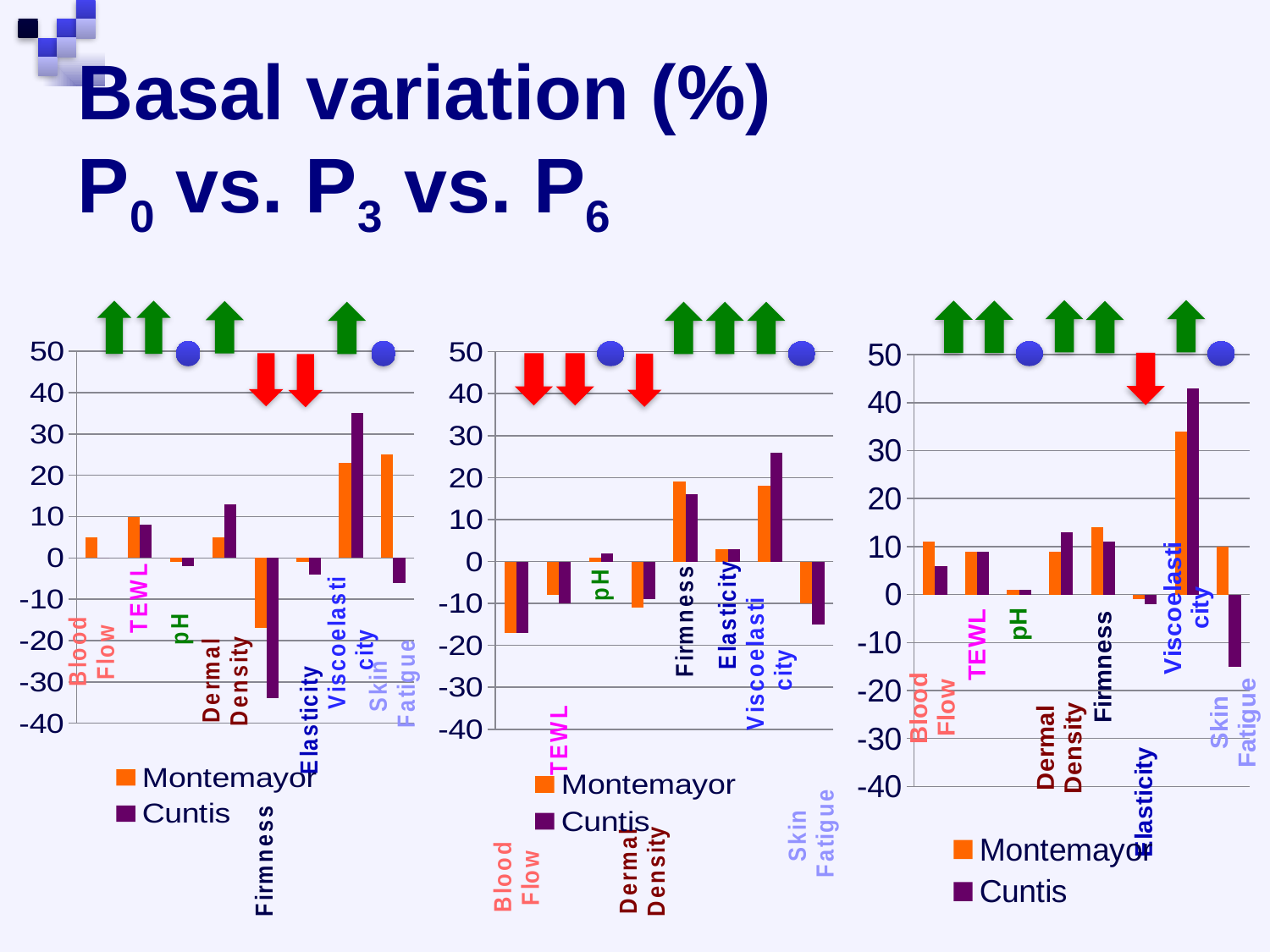
In the left chart, which series has the larger value for Viscoelasticity, Montemayor or Cuntis? Cuntis In the right chart, which category has the lowest Cuntis value? Skin Fatigue How many series does the legend of the middle chart list? 2 In the middle chart, is the Cuntis value for Viscoelasticity greater or less than 20? greater How many categories are plotted on the x axis of the right chart? 8 In the middle chart, which category has the lowest Montemayor value? Blood Flow In the right chart, which category has the highest Cuntis value? Viscoelasticity In the left chart, which category has the lowest Cuntis value? Firmness In the left chart, is the Cuntis value for Firmness greater or less than -30? less What kind of chart is the left chart on the slide? bar chart In the left chart, is the Cuntis value for Viscoelasticity greater or less than 30? greater In the left chart, which category has the highest Cuntis value? Viscoelasticity